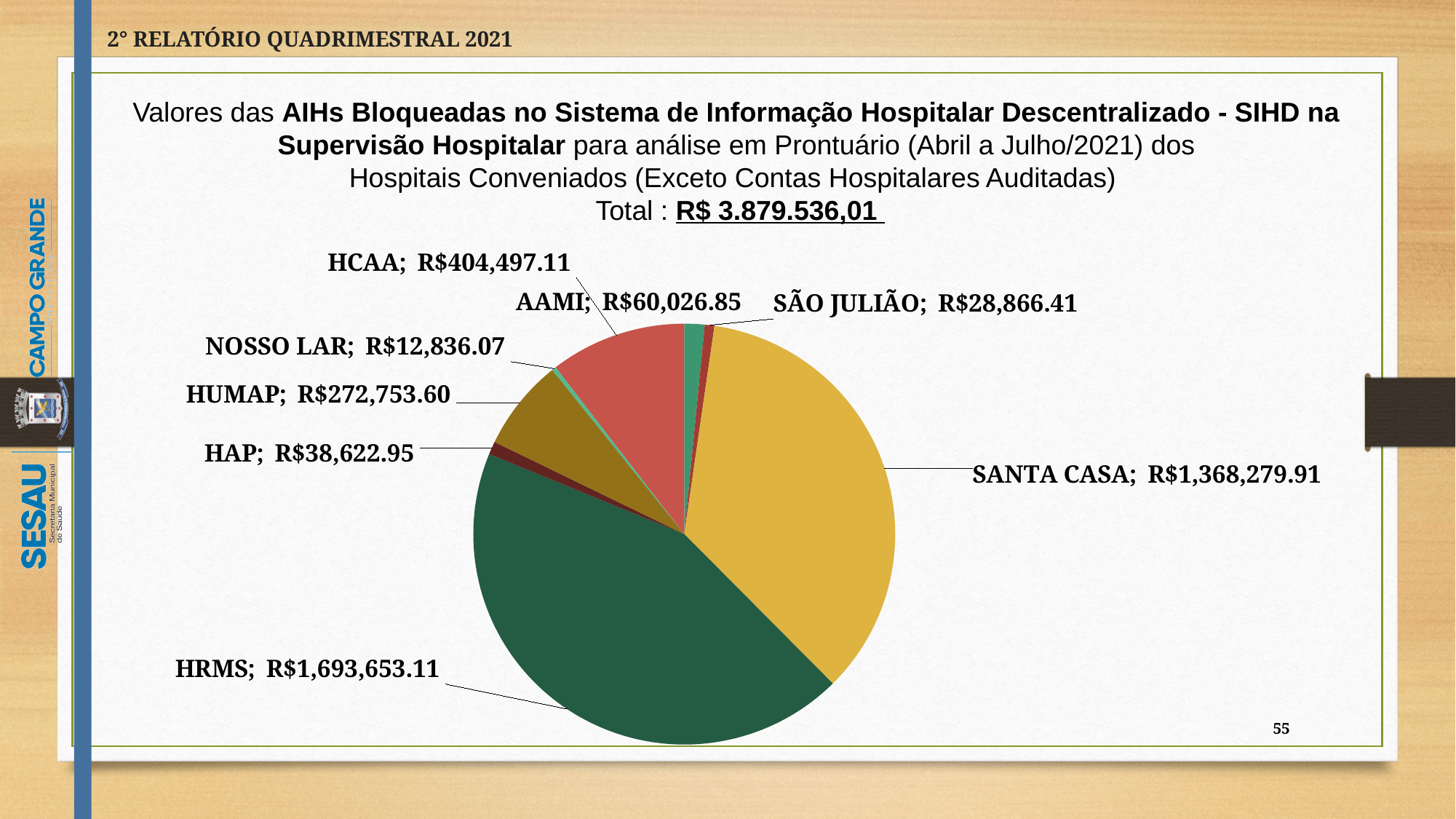
What total value is stated on the slide for the blocked AIHs? R$ 3.879.536,01 Which hospital has the largest slice of the pie? HRMS What type of chart is shown on the slide? Pie chart What is the value for SANTA CASA? R$1,368,279.91 What is the difference between the values for HRMS and SANTA CASA? R$325,373.20 Which hospital has the smallest slice of the pie? NOSSO LAR What is the value for NOSSO LAR? R$12,836.07 Which is larger, the value for AAMI or the value for HAP? AAMI What is the difference between the values for HCAA and HUMAP? R$131,743.51 What colour is the SANTA CASA slice? Yellow What is the value for HUMAP? R$272,753.60 How many slices (hospitals) does the pie chart have? 8